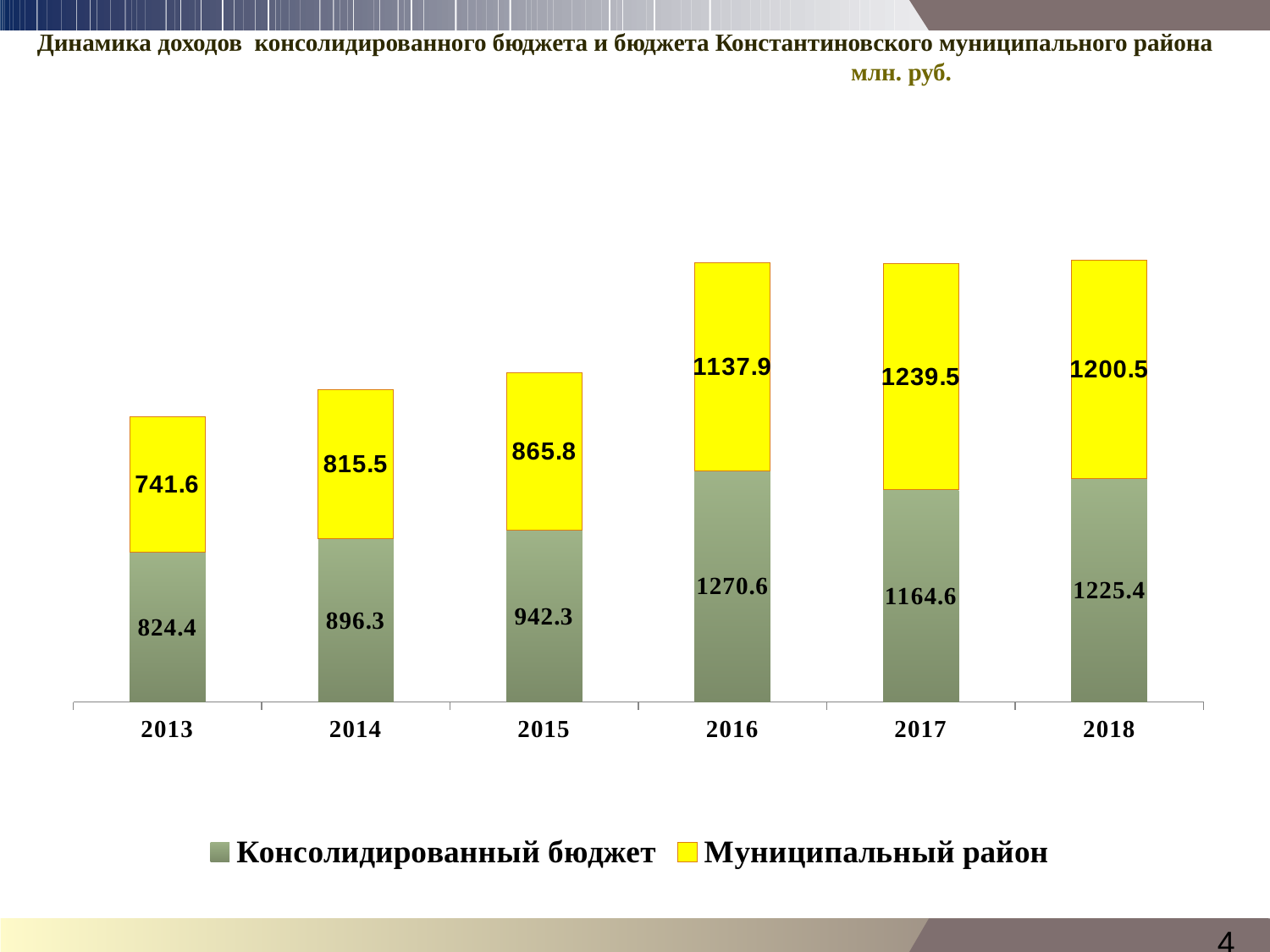
In which year is Муниципальный район lowest? 2013 What is the total of the stacked bar for 2013? 1566.0 Does Муниципальный район rise or fall from 2013 to 2017? rise Which is larger in 2016: Консолидированный бюджет or Муниципальный район? Консолидированный бюджет What colour represents Муниципальный район in the chart? yellow In which year is Консолидированный бюджет highest? 2016 How many years are shown on the x axis? 6 What type of chart is shown on the slide? stacked bar chart What is the value of Муниципальный район in 2017? 1239.5 What is the difference between Консолидированный бюджет in 2016 and in 2013? 446.2 How many series does the legend list? 2 What is the value of Консолидированный бюджет in 2015? 942.3